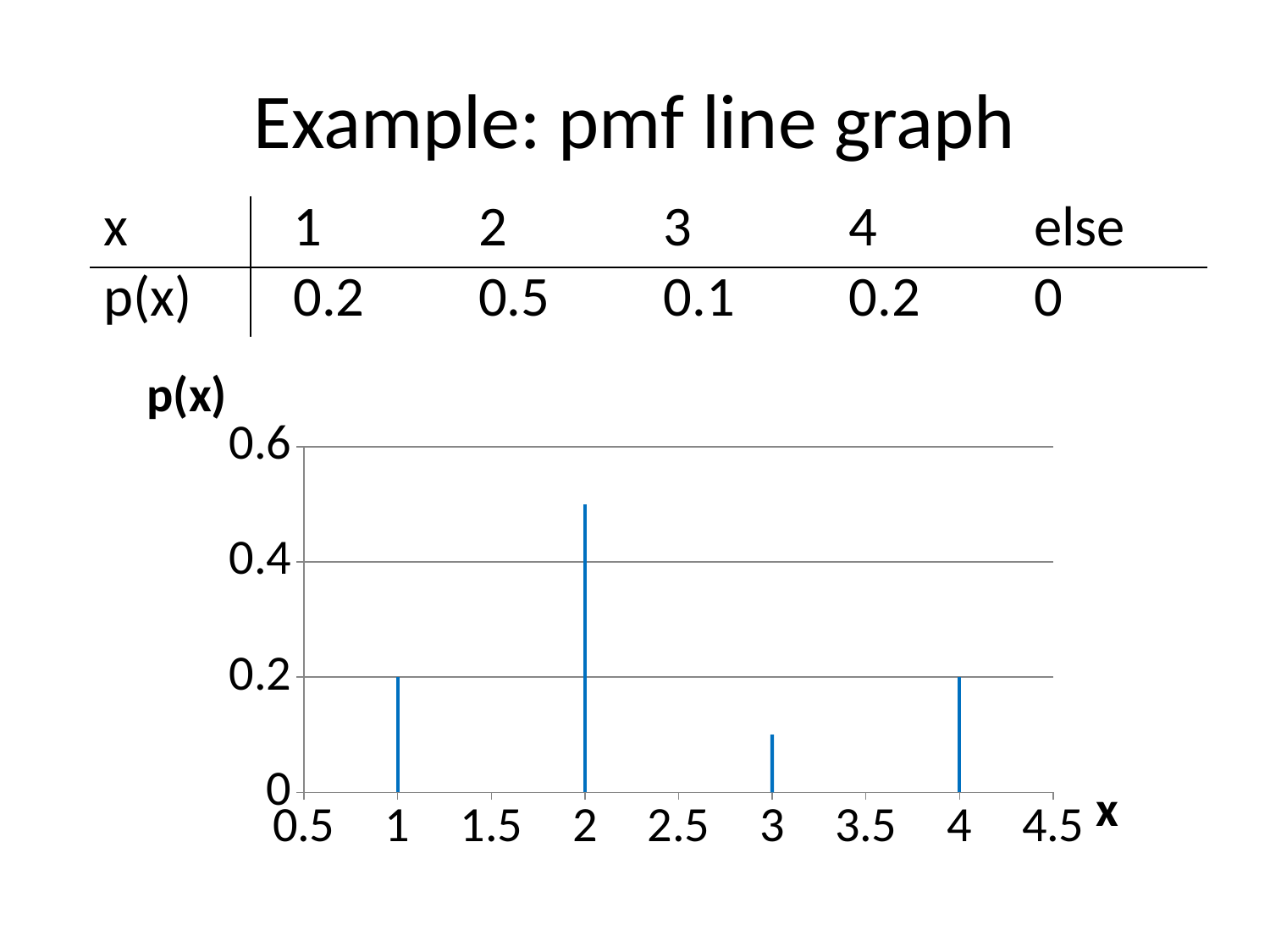
What is the value of p(x) at x = 4 in the chart? 0.2 What is the difference between p(x) at x = 2 and p(x) at x = 3? 0.4 What is the value of p(x) at x = 2 in the chart? 0.5 What is the value of p(x) at x = 1 in the chart? 0.2 How many x values have a nonzero p(x) plotted in the chart? 4 What is the label on the vertical axis of the chart? p(x) At which value of x is p(x) highest in the chart? 2 At which value of x is p(x) lowest in the chart? 3 What is the difference between p(x) at x = 2 and p(x) at x = 1? 0.3 Which is larger in the chart: p(x) at x = 1 or p(x) at x = 3? x = 1 What is the value of p(x) at x = 3 in the chart? 0.1 Is the value of p(x) at x = 2 greater or less than 0.4? greater